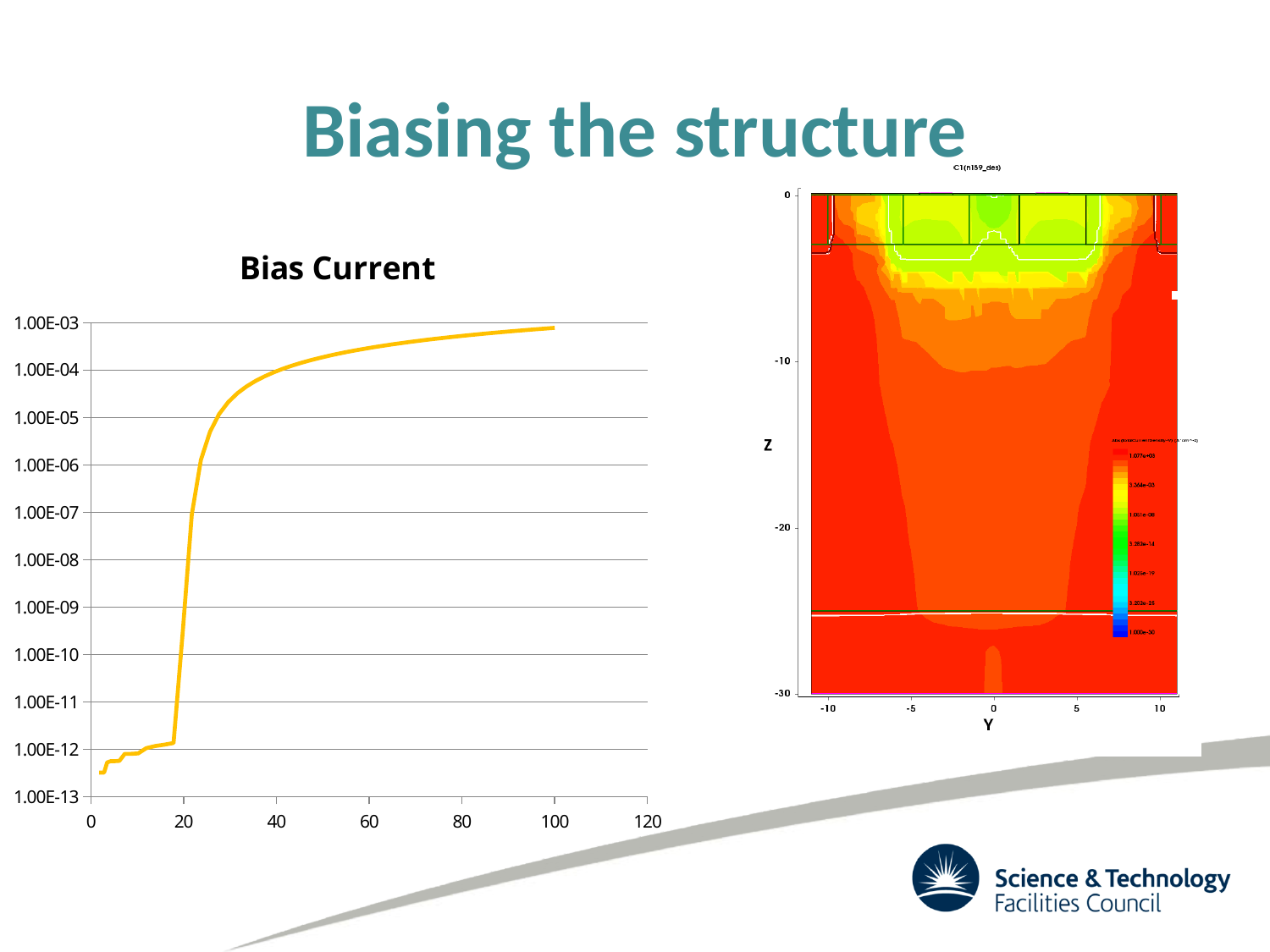
In the "Bias Current" chart, is the value at x = 100 greater or less than 1.00E-04? greater How many lines are plotted in the "Bias Current" chart? 1 In the "Bias Current" chart, is the value at x = 40 greater or less than 1.00E-03? less In the "Bias Current" chart, which is larger: the value at x = 20 or the value at x = 80? x = 80 What is the label on the horizontal axis of the contour plot on the right of the slide? Y In the "Bias Current" chart, is the value at x = 10 greater or less than 1.00E-11? less In the "Bias Current" chart, do the values rise or fall as the x axis increases from 0 to 100? rise What is the title of the line chart on the left of the slide? Bias Current What kind of chart is the "Bias Current" chart? line chart